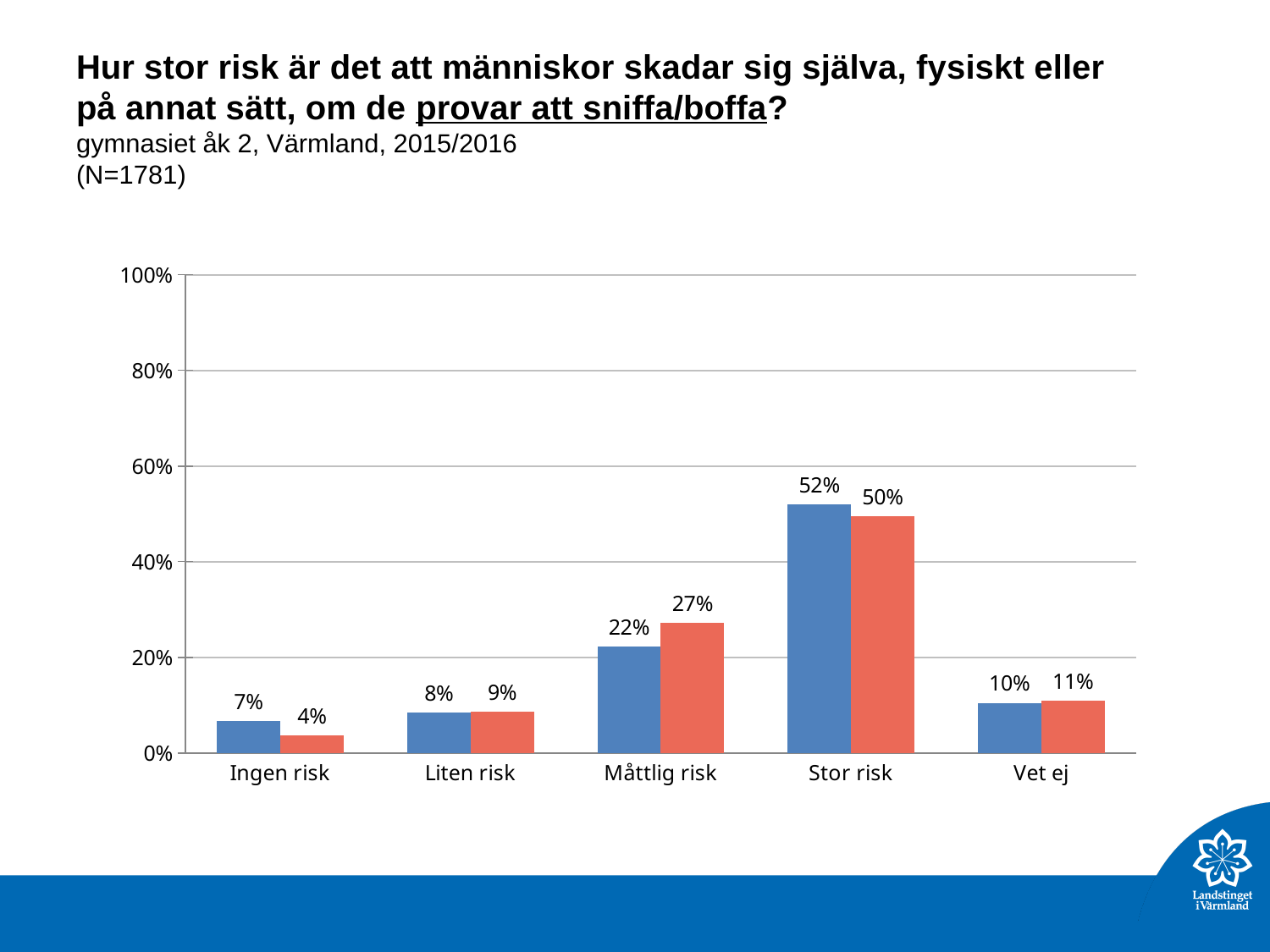
What is the sample size (N) stated on the slide? 1781 What kind of chart is shown on the slide? bar chart For Ingen risk, which bar is larger, the blue or the red? blue Which category has the lowest red bar? Ingen risk What is the value of the blue bar for Stor risk? 52% What is the value of the red bar for Måttlig risk? 27% Which category has the highest blue bar? Stor risk What is the difference between the red and blue bars for Måttlig risk? 5% What is the value of the red bar for Ingen risk? 4% Is the value of the blue bar for Stor risk greater or less than 40%? greater How many categories are shown on the x axis? 5 What is the value of the blue bar for Vet ej? 10%